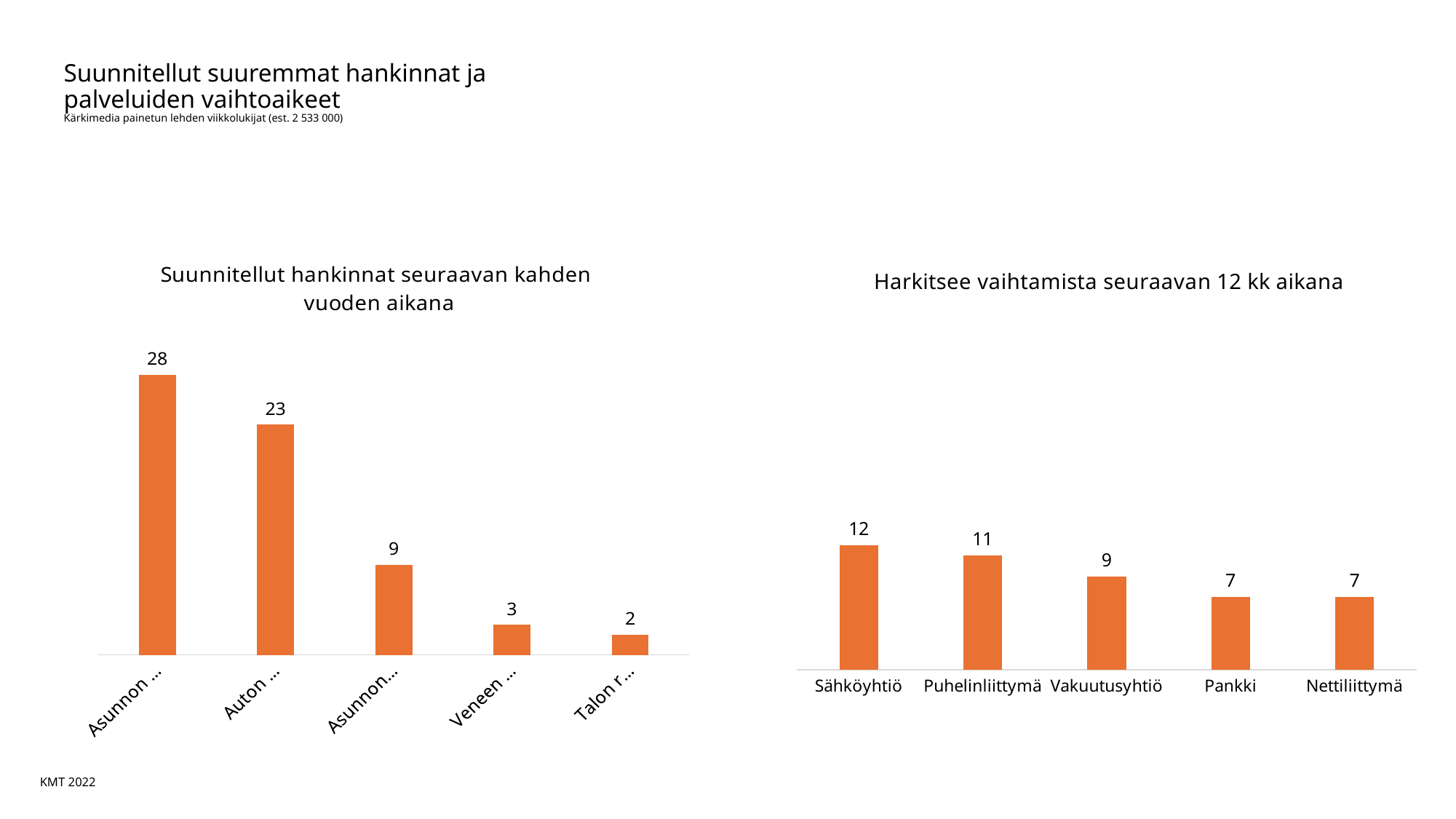
In the chart 'Harkitsee vaihtamista seuraavan 12 kk aikana', which is larger, Puhelinliittymä or Vakuutusyhtiö? Puhelinliittymä In the chart 'Harkitsee vaihtamista seuraavan 12 kk aikana', what is the value for Pankki? 7 What type of chart is 'Harkitsee vaihtamista seuraavan 12 kk aikana'? bar chart In the chart 'Suunnitellut hankinnat seuraavan kahden vuoden aikana', what is the lowest value shown? 2 In the chart 'Harkitsee vaihtamista seuraavan 12 kk aikana', what is the value for Vakuutusyhtiö? 9 How many categories are shown in the chart 'Harkitsee vaihtamista seuraavan 12 kk aikana'? 5 In the chart 'Suunnitellut hankinnat seuraavan kahden vuoden aikana', what is the difference between the first bar and the second bar? 5 In the chart 'Harkitsee vaihtamista seuraavan 12 kk aikana', which category has the highest value? Sähköyhtiö In the chart 'Harkitsee vaihtamista seuraavan 12 kk aikana', what is the difference between Sähköyhtiö and Puhelinliittymä? 1 In the chart 'Suunnitellut hankinnat seuraavan kahden vuoden aikana', what is the highest value shown? 28 In the chart 'Harkitsee vaihtamista seuraavan 12 kk aikana', what is the value for Sähköyhtiö? 12 In the chart 'Suunnitellut hankinnat seuraavan kahden vuoden aikana', do the values rise or fall from left to right? fall